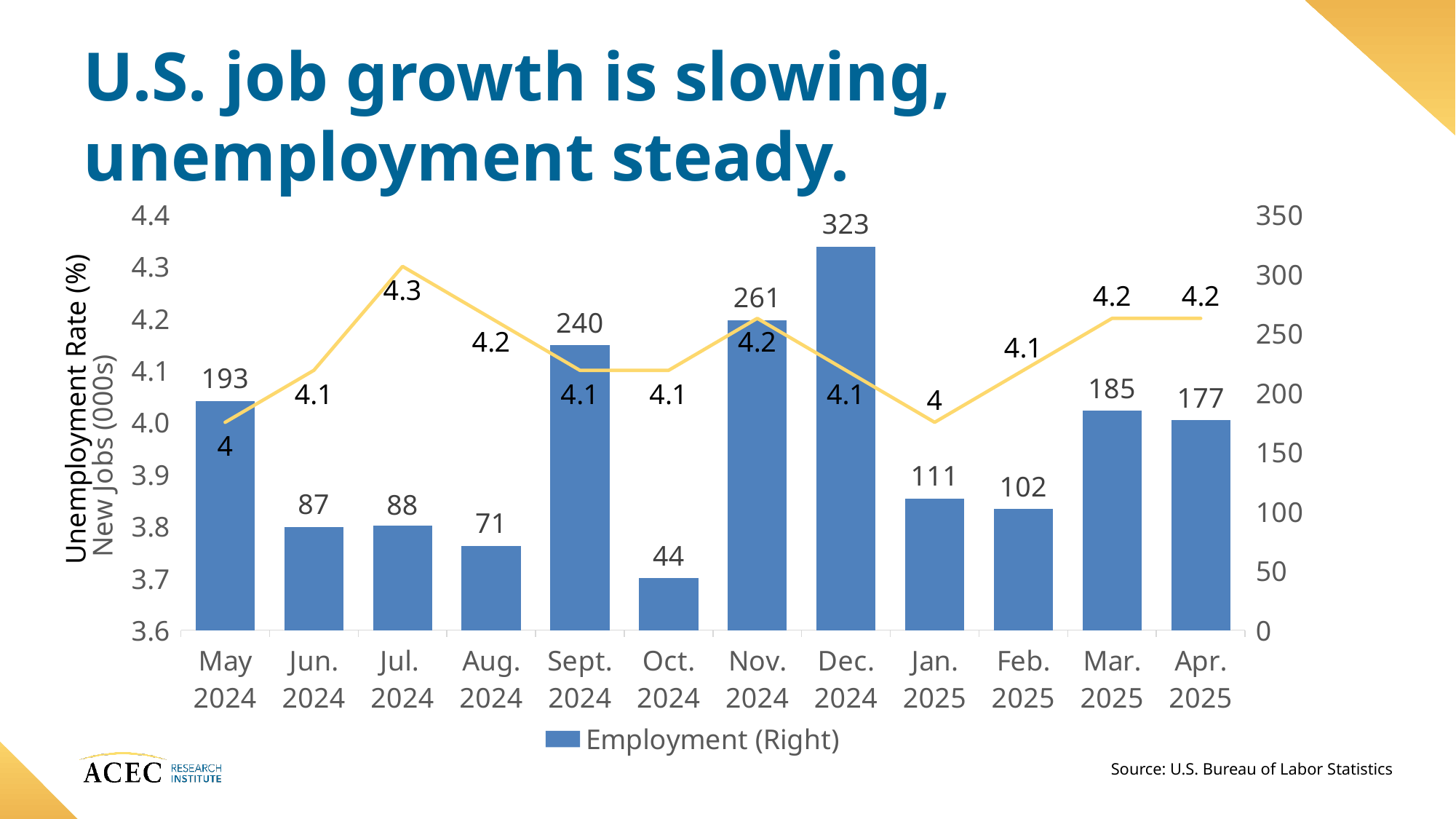
Which has the larger Employment value, Mar. 2025 or Apr. 2025? Mar. 2025 Do the Employment values rise or fall from Dec. 2024 to Feb. 2025? Fall What is the difference between the Employment values for Dec. 2024 and Nov. 2024? 62 How many series does the legend list? 1 Which month has the highest Employment value? Dec. 2024 What is the unemployment rate shown for Jul. 2024? 4.3 What is the unemployment rate shown for Apr. 2025? 4.2 What kind of chart is shown on the slide? Combined bar and line chart Which month has the highest unemployment rate on the line? Jul. 2024 How many months are shown on the x axis? 12 Which month has the lowest Employment value? Oct. 2024 What is the Employment value for Dec. 2024? 323